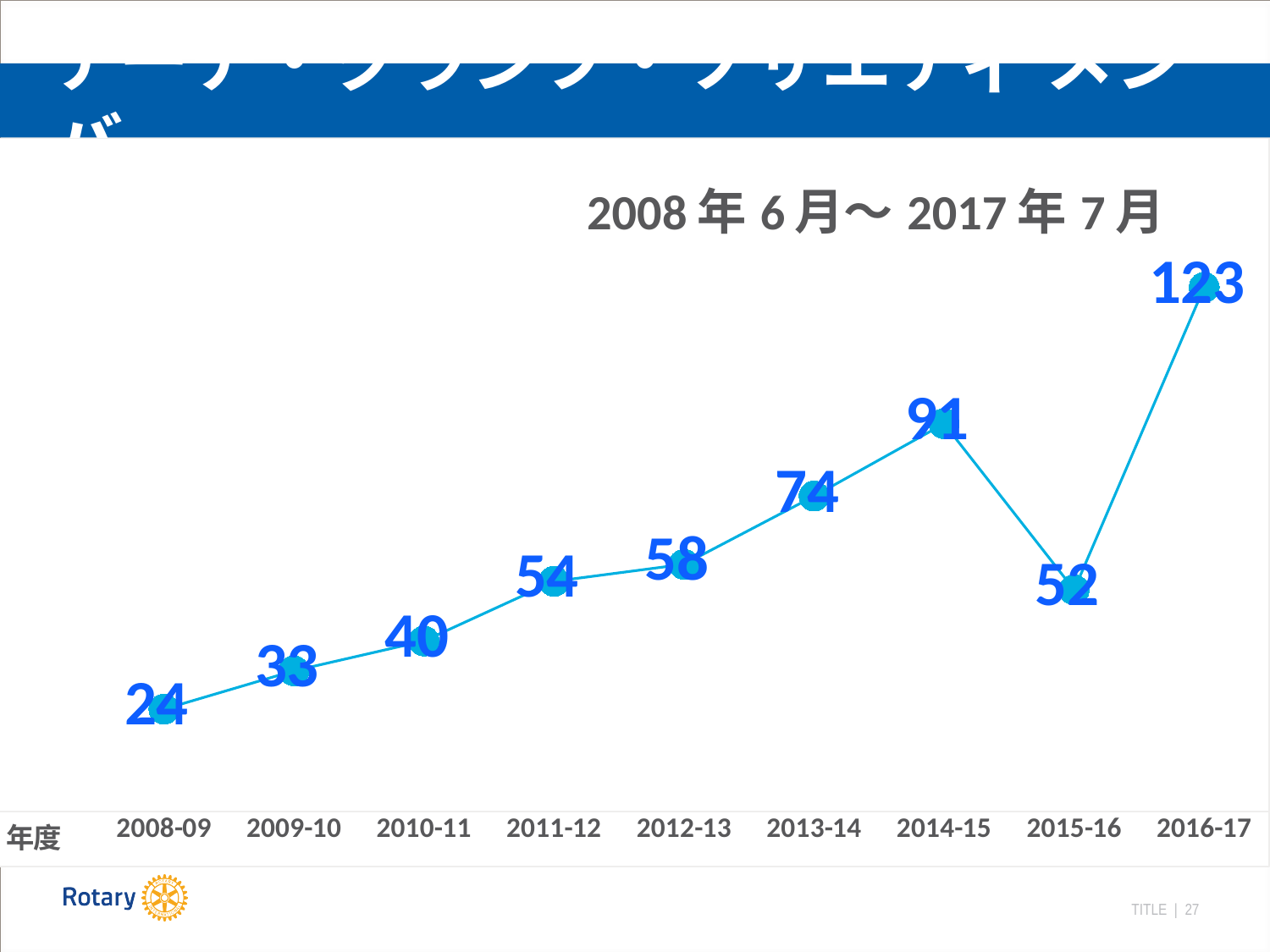
What is the value for 2014-15? 91 What is the value for 2015-16? 52 Which year has the lowest value? 2008-09 Which is larger, the value for 2012-13 or the value for 2015-16? 2012-13 What is the difference between the values for 2014-15 and 2013-14? 17 What is the difference between the values for 2016-17 and 2015-16? 71 What is the value for 2011-12? 54 How many data points are plotted on the chart? 9 Which year has the highest value? 2016-17 What kind of chart is shown on the slide? line chart Do the values rise or fall from 2008-09 to 2014-15? rise What is the value for 2008-09? 24